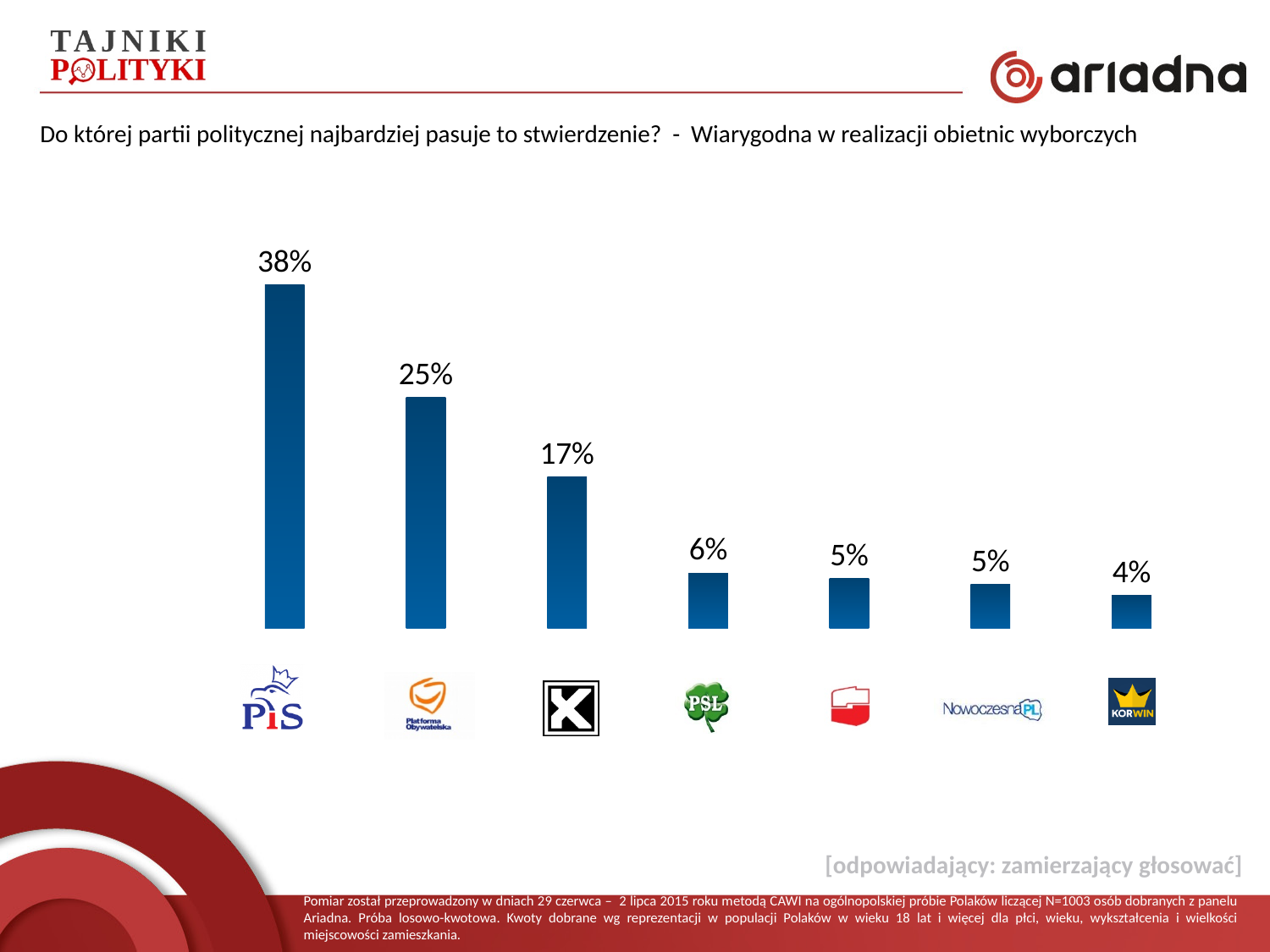
Do the values rise or fall from left to right across the chart? fall What is the value for Platforma Obywatelska? 25% Which party has the lowest value? KORWIN What is the difference between the values for PiS and Platforma Obywatelska? 13% What is the value for PSL? 6% Which party has the highest value? PiS What is the value for KORWIN? 4% How many bars does the chart show? 7 What is the value of the third bar from the left? 17% Which is larger, the value for PSL or the value for Nowoczesna PL? PSL What type of chart is shown on the slide? bar chart What is the value for PiS? 38%